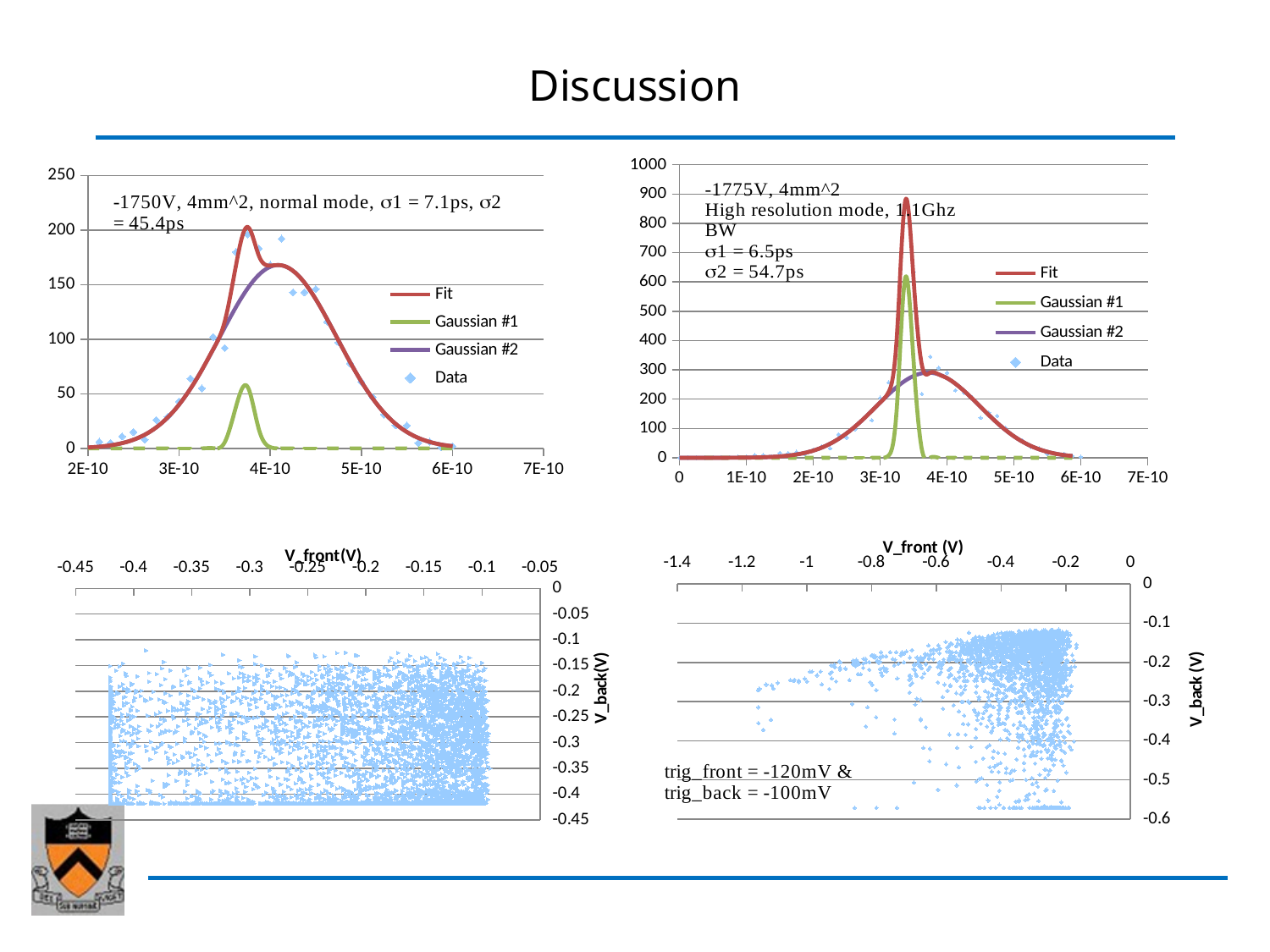
In the top-left chart, is the peak value of the Fit curve greater or less than 150? greater What kind of chart is the bottom-left chart? scatter chart In the top-right chart, is the peak of the Gaussian #2 curve greater or less than 400? less In the top-right chart, how many series does the legend list? 4 Which chart has the higher peak Fit value, the top-left chart or the top-right chart? top-right chart What is the x-axis label of the bottom-right chart? V_front (V) According to the annotation on the top-left chart, what is the value of σ1? 7.1ps In the top-left chart, how many series does the legend list? 4 In the top-left chart, what are the legend entries? Fit, Gaussian #1, Gaussian #2, Data In the top-left chart, is the peak of the Gaussian #1 curve greater or less than 100? less According to the annotation on the top-right chart, what is the value of σ2? 54.7ps